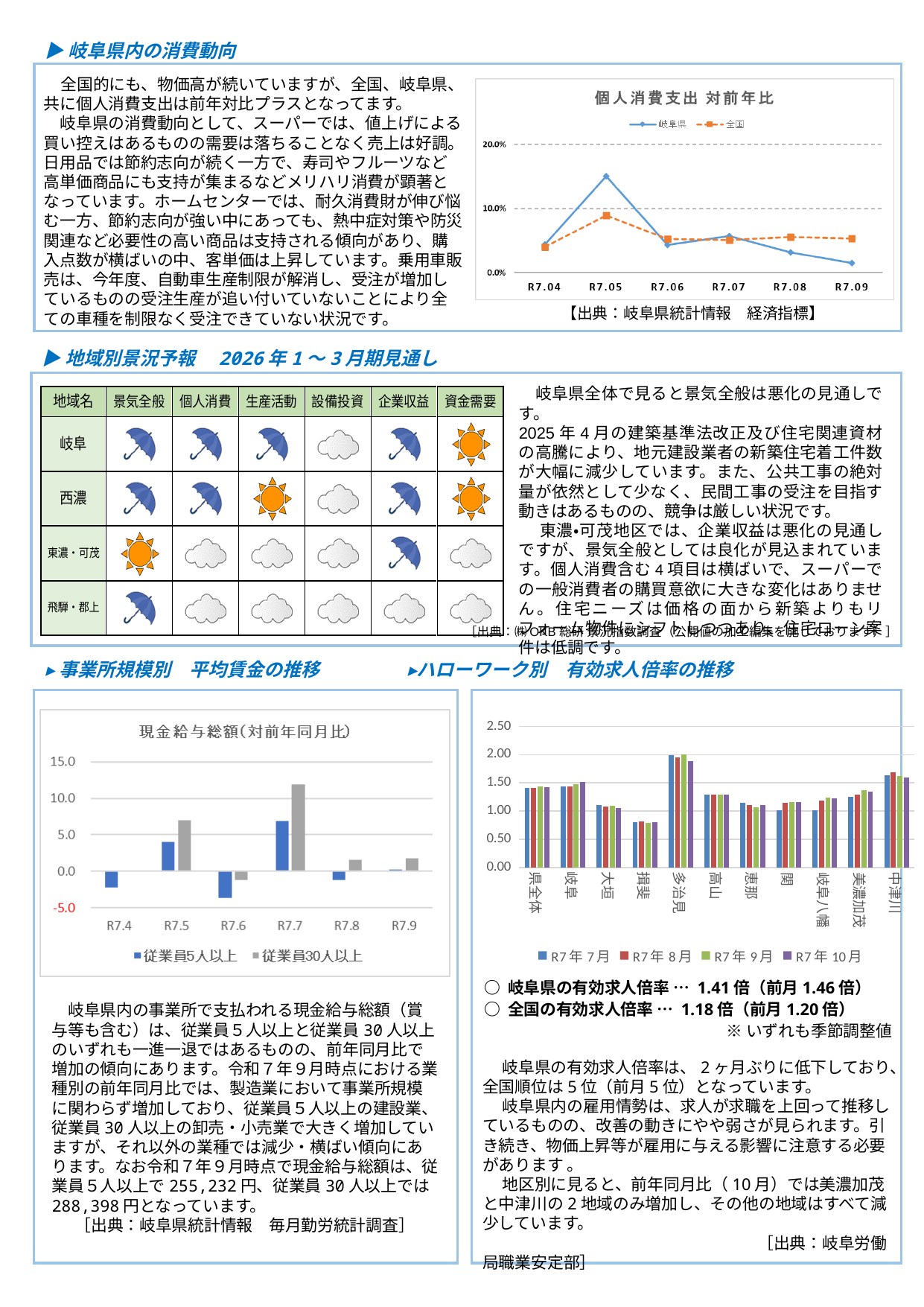
In the ハローワーク別 有効求人倍率の推移 chart, which area has the highest bars? 多治見 In the ハローワーク別 有効求人倍率の推移 chart, how many series does the legend list? 4 In the 現金給与総額(対前年同月比) chart, is the 従業員30人以上 value at R7.7 greater or less than 10.0? greater In the 現金給与総額(対前年同月比) chart, at which month is the 従業員30人以上 series highest? R7.7 What kind of chart is the 個人消費支出 対前年比 chart? line chart In the 個人消費支出 対前年比 chart, is the 全国 value at R7.05 greater or less than 10.0%? less In the 個人消費支出 対前年比 chart, is the 岐阜県 value at R7.05 greater or less than 10.0%? greater In the 個人消費支出 対前年比 chart, how many months are plotted on the x axis? 6 In the 個人消費支出 対前年比 chart, how many series does the legend list? 2 In the 個人消費支出 対前年比 chart, at which month does the 岐阜県 series reach its highest value? R7.05 What kind of chart is the 現金給与総額(対前年同月比) chart? bar chart